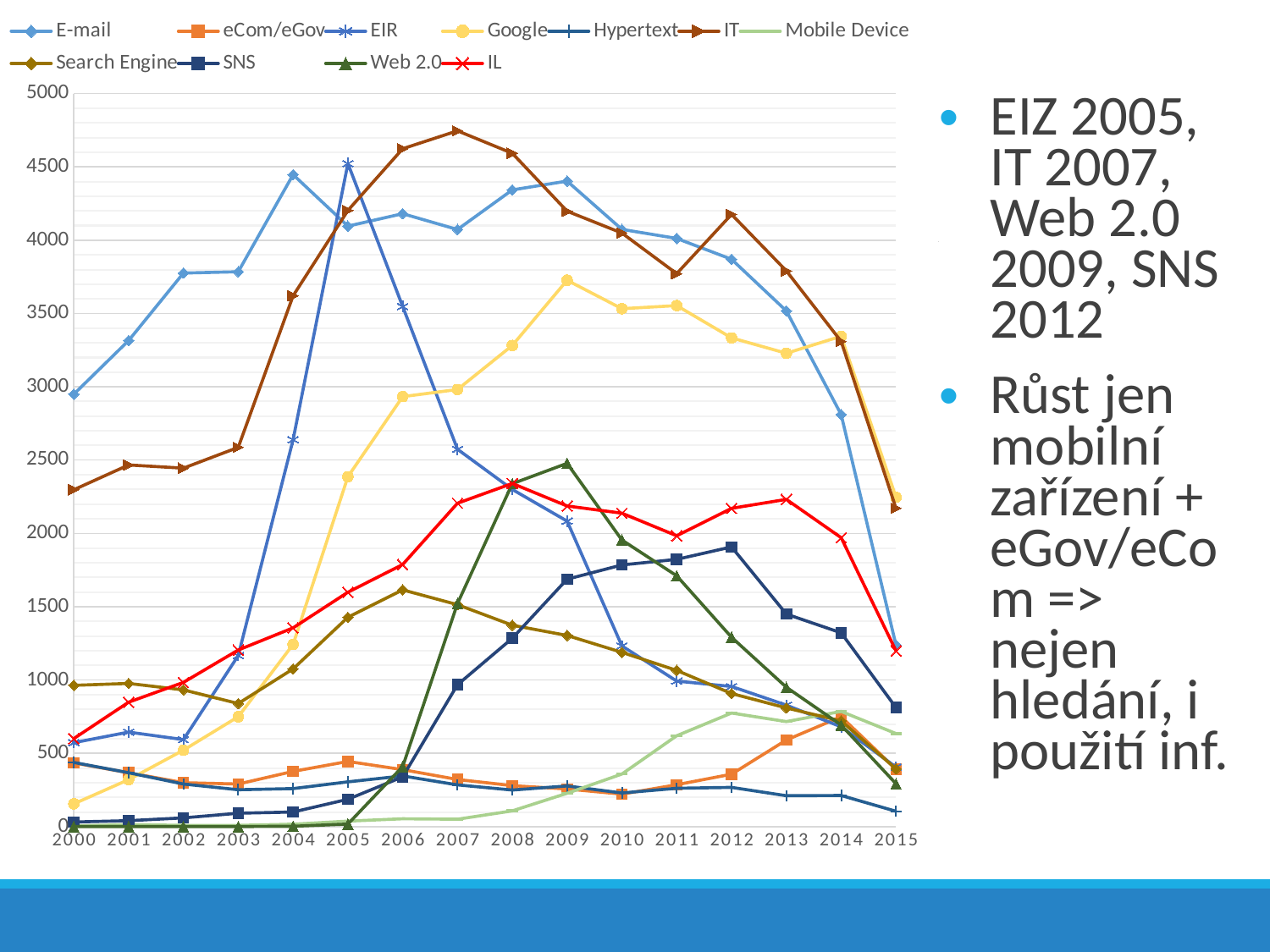
Is the value for Web 2.0 in 2009 greater or less than 2000? greater How many series does the legend list? 11 Which is larger in 2015, the value for IT or the value for E-mail? IT Is the value for E-mail in 2004 greater or less than 4000? greater Is the value for Mobile Device in 2012 greater or less than 1000? less How many years are shown along the x axis? 16 Which series has the highest value in 2007? IT Which series has the highest value in 2000? E-mail Which is larger in 2010, the value for E-mail or the value for Google? E-mail What kind of chart is shown on the slide? line chart Does the EIR series rise or fall from 2005 to 2015? fall In which year does the IT series reach its highest value? 2007